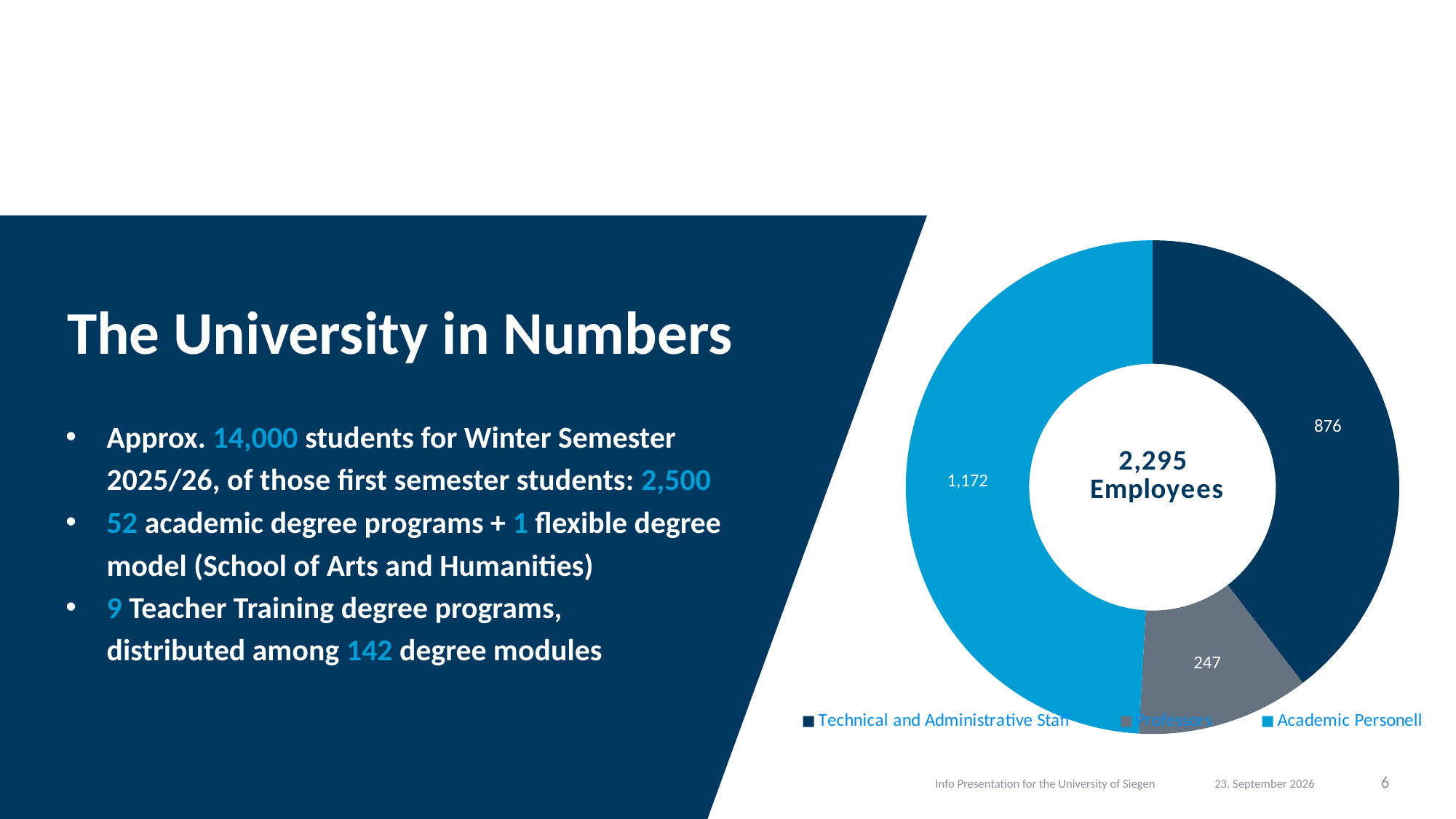
Which is larger, Technical and Administrative Staff or Professors? Technical and Administrative Staff What is the difference between Academic Personell and Technical and Administrative Staff? 296 What is the difference between Technical and Administrative Staff and Professors? 629 Which colour represents Professors in the chart? grey How many employees are Technical and Administrative Staff? 876 Which category has the largest number of employees? Academic Personell What is the value shown for Professors? 247 What kind of chart is shown on the slide? doughnut chart What total number of employees is shown in the centre of the chart? 2,295 What is the value shown for Academic Personell? 1,172 Which category has the smallest number of employees? Professors How many categories does the chart show? 3